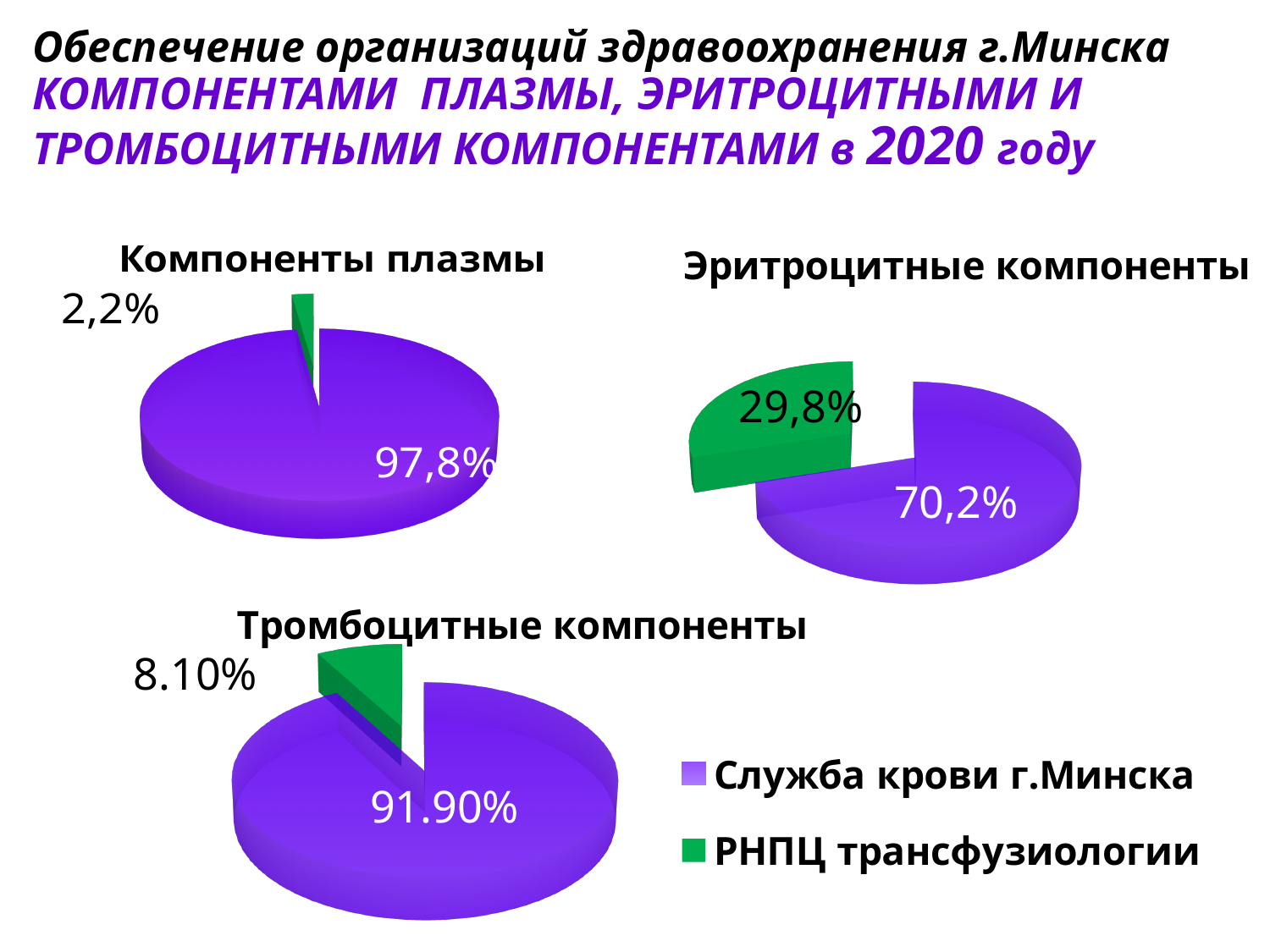
In the 'Тромбоцитные компоненты' chart, what share does 'Служба крови г.Минска' have? 91.90% Which chart shows a larger share for 'РНПЦ трансфузиологии': 'Эритроцитные компоненты' or 'Тромбоцитные компоненты'? Эритроцитные компоненты What type of chart is 'Тромбоцитные компоненты'? Pie chart How many entries does the legend on the slide list? 2 In the 'Компоненты плазмы' chart, what share does 'РНПЦ трансфузиологии' have? 2,2% In the 'Компоненты плазмы' chart, what share does 'Служба крови г.Минска' have? 97,8% In the 'Эритроцитные компоненты' chart, which category has the largest share? Служба крови г.Минска In the 'Тромбоцитные компоненты' chart, what share does 'РНПЦ трансфузиологии' have? 8.10% In the 'Эритроцитные компоненты' chart, what is the difference between the shares of 'Служба крови г.Минска' and 'РНПЦ трансфузиологии'? 40,4% In the 'Эритроцитные компоненты' chart, what share does 'РНПЦ трансфузиологии' have? 29,8% In the 'Эритроцитные компоненты' chart, what share does 'Служба крови г.Минска' have? 70,2% In the 'Компоненты плазмы' chart, which category has the smallest share? РНПЦ трансфузиологии